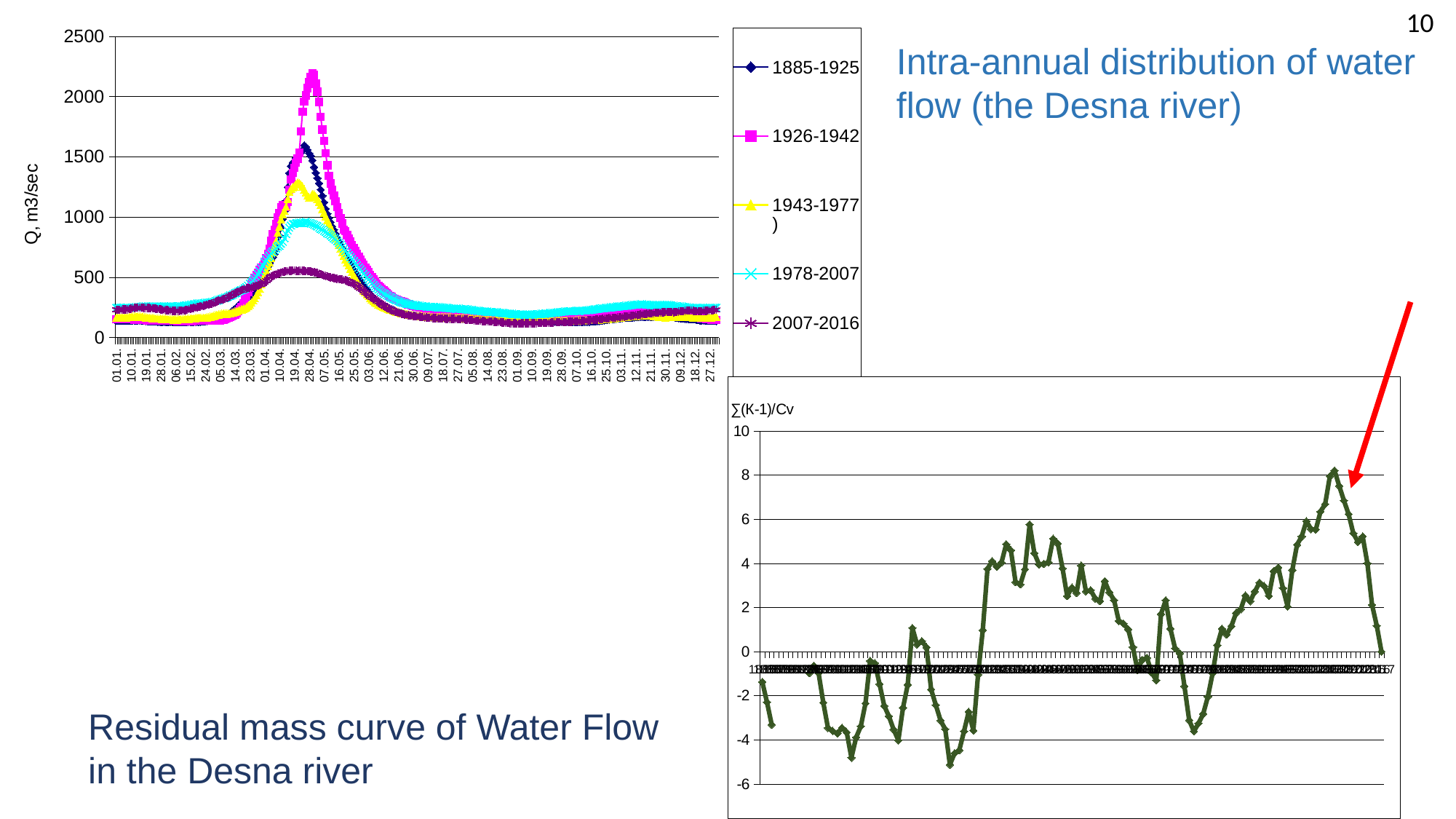
On the Intra-annual distribution of water flow chart, is the peak value of the 2007-2016 series greater or less than 1000? less On the Intra-annual distribution of water flow chart, which series reaches the highest peak? 1926-1942 What is the y-axis label of the Intra-annual distribution of water flow chart? Q, m3/sec What kind of chart is the Intra-annual distribution of water flow chart? line chart On the Intra-annual distribution of water flow chart, is the peak value of the 1926-1942 series greater or less than 2000? greater On the Residual mass curve chart, is the highest value of the curve greater or less than 6? greater On the Intra-annual distribution of water flow chart, which series has the higher peak, 1885-1925 or 1978-2007? 1885-1925 On the Intra-annual distribution of water flow chart, how many series does the legend list? 5 On the Intra-annual distribution of water flow chart, which series has the lowest peak? 2007-2016 What kind of chart is the Residual mass curve of Water Flow in the Desna river? line chart